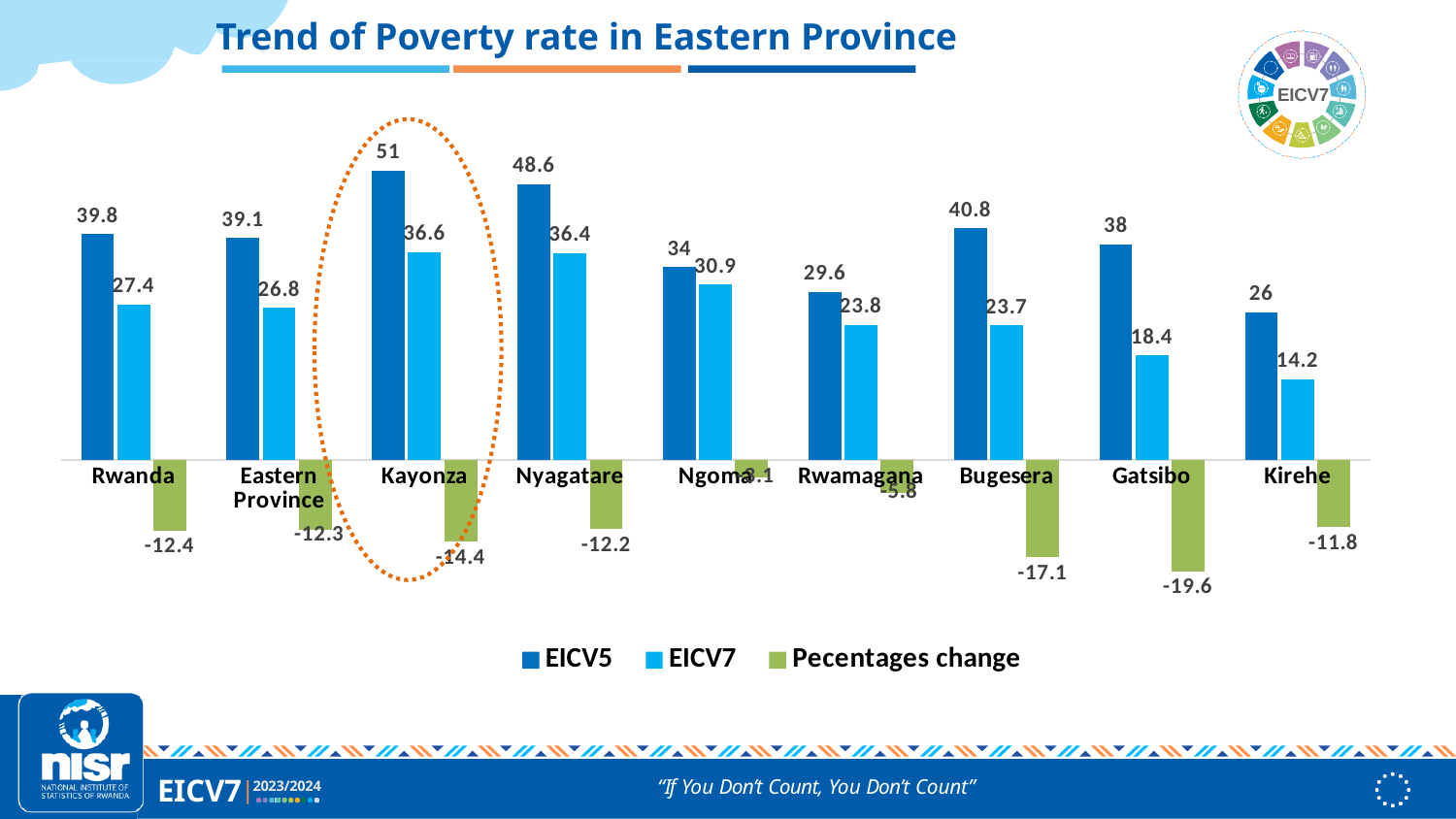
Which category has the lowest EICV7 poverty rate? Kirehe What kind of chart is shown on the slide? Bar chart Which category is circled with a dotted orange outline on the chart? Kayonza Which category has the highest EICV5 poverty rate? Kayonza How many series does the legend list? 3 What is the percentage change shown for Bugesera? -17.1 What is the difference between the EICV5 and EICV7 poverty rates for Nyagatare? 12.2 What is the EICV5 poverty rate for Kayonza? 51 How many categories are shown on the x axis of the chart? 9 Which is larger, the EICV7 poverty rate for Ngoma or for Rwamagana? Ngoma What is the title of the chart? Trend of Poverty rate in Eastern Province What is the EICV7 poverty rate for Gatsibo? 18.4